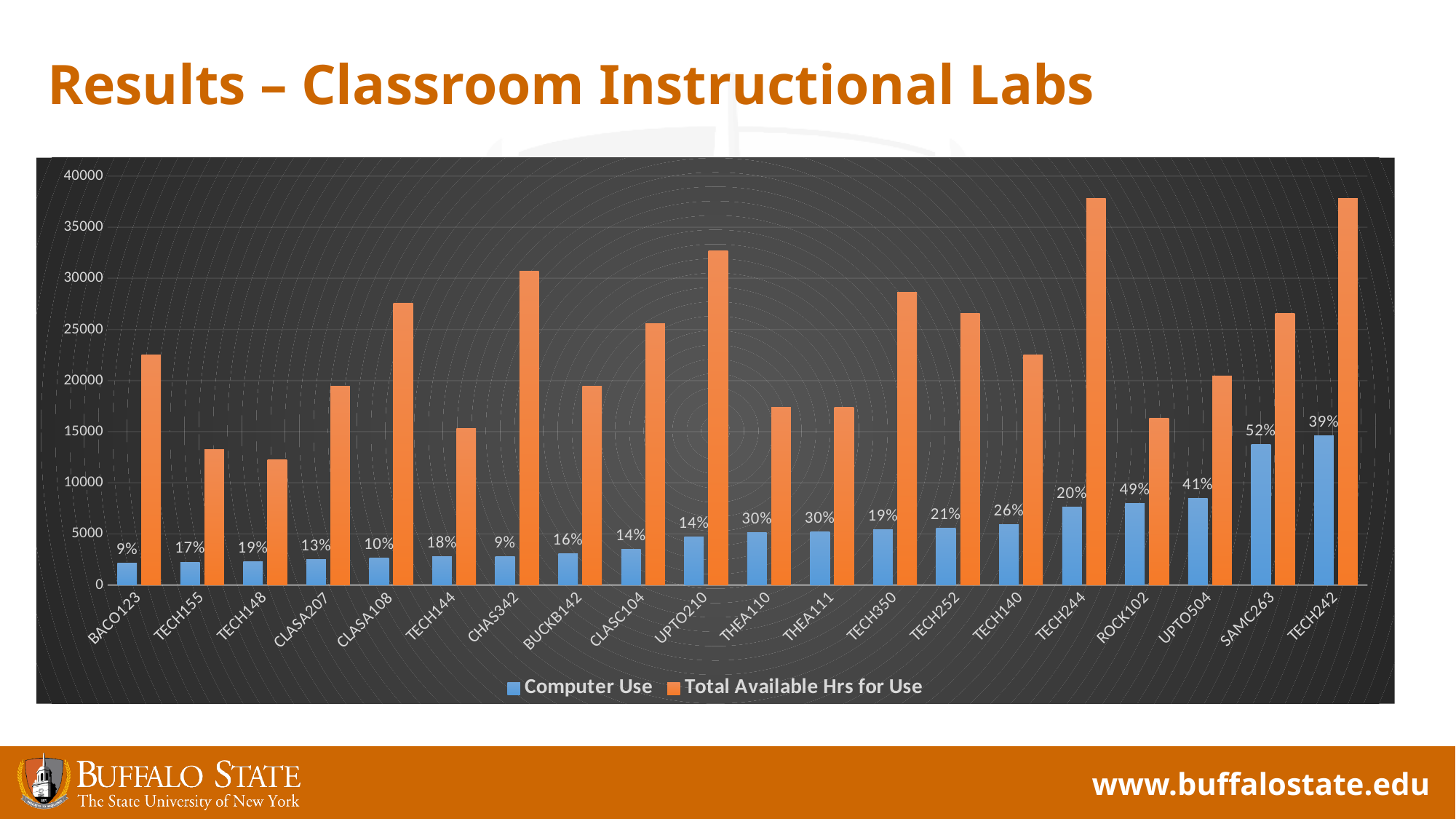
Is the Total Available Hrs for Use value for TECH155 greater or less than 15000? less How many series does the legend list? 2 What percentage label is shown above the Computer Use bar for ROCK102? 49% What is the difference between the percentage labels for SAMC263 and TECH242? 13 percentage points Do the Computer Use bars generally rise or fall from left to right along the x axis? rise What percentage label is shown above the Computer Use bar for THEA110? 30% How many classroom labs (categories) are shown on the x axis? 20 Is the Total Available Hrs for Use value for TECH244 greater or less than 35000? greater Which has a larger Total Available Hrs for Use value, UPTO210 or CLASA108? UPTO210 What type of chart is shown on the slide? bar chart Which lab has the highest percentage label above its Computer Use bar? SAMC263 What percentage label is shown above the Computer Use bar for BACO123? 9%